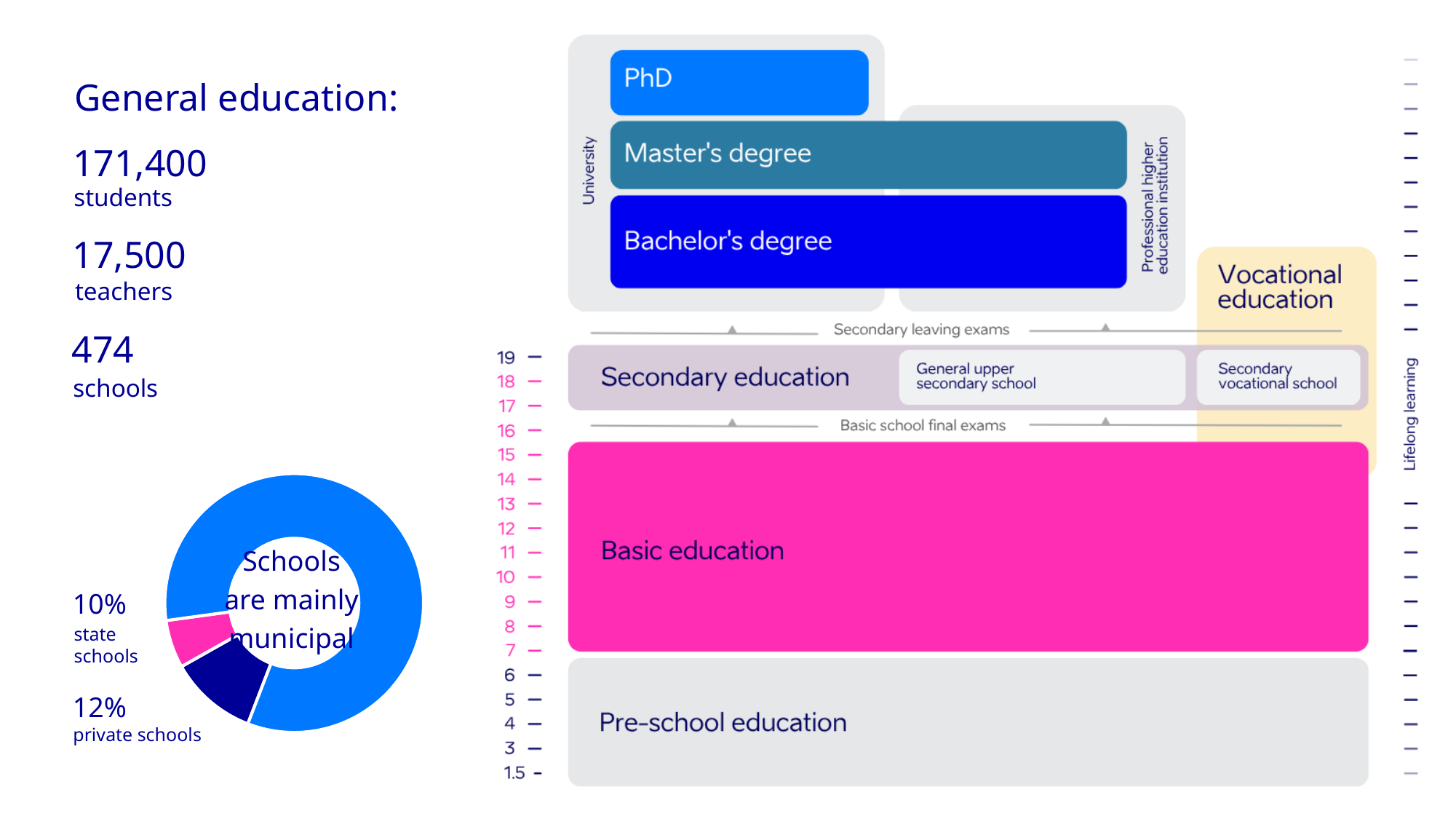
What kind of chart is shown on the left of the slide? Pie (donut) chart Which slice of the pie chart is the largest? Municipal schools How many slices does the pie chart have? 3 What text is written in the centre of the pie chart? Schools are mainly municipal What share of schools are private schools according to the pie chart? 12% What is the difference between the share of private schools and the share of state schools in the pie chart? 2% Which slice of the pie chart is the smallest? State schools Which is larger in the pie chart: the share of state schools or the share of private schools? Private schools What colour is the slice for private schools in the pie chart? Dark navy blue What share of schools are state schools according to the pie chart? 10%